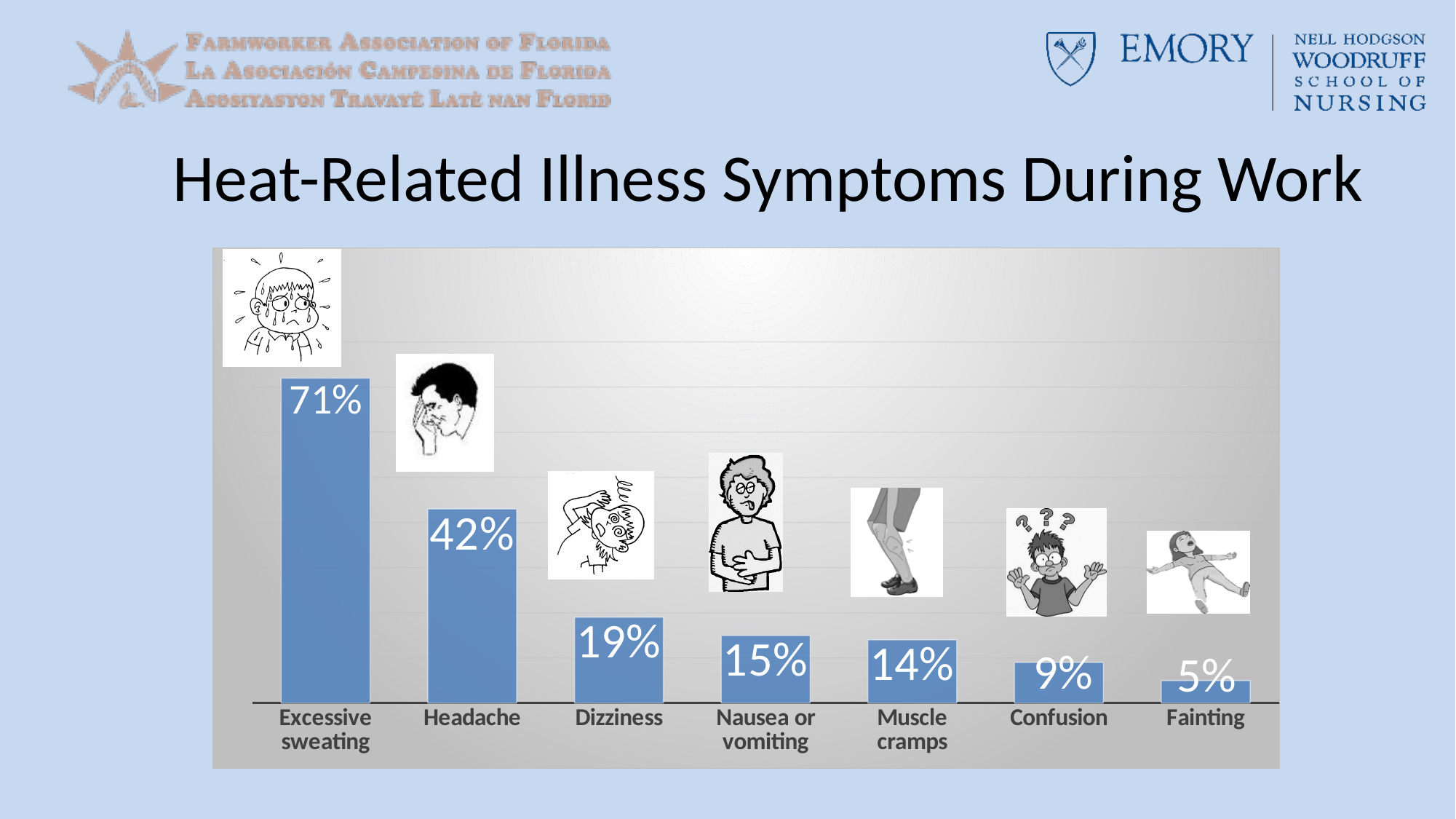
What is the difference between the percentages for Excessive sweating and Headache? 29% Which symptom has the lowest percentage? Fainting How many symptom categories are shown in the chart? 7 What percentage is shown for Nausea or vomiting? 15% What is the title of the slide containing the chart? Heat-Related Illness Symptoms During Work What kind of chart is shown on the slide? Bar chart What is the difference between the values for Dizziness and Confusion? 10% Which symptom has the highest percentage? Excessive sweating What is the value shown for Headache? 42% What percentage of workers reported excessive sweating? 71% Which is larger, the value for Dizziness or the value for Nausea or vomiting? Dizziness What is the value for Muscle cramps? 14%